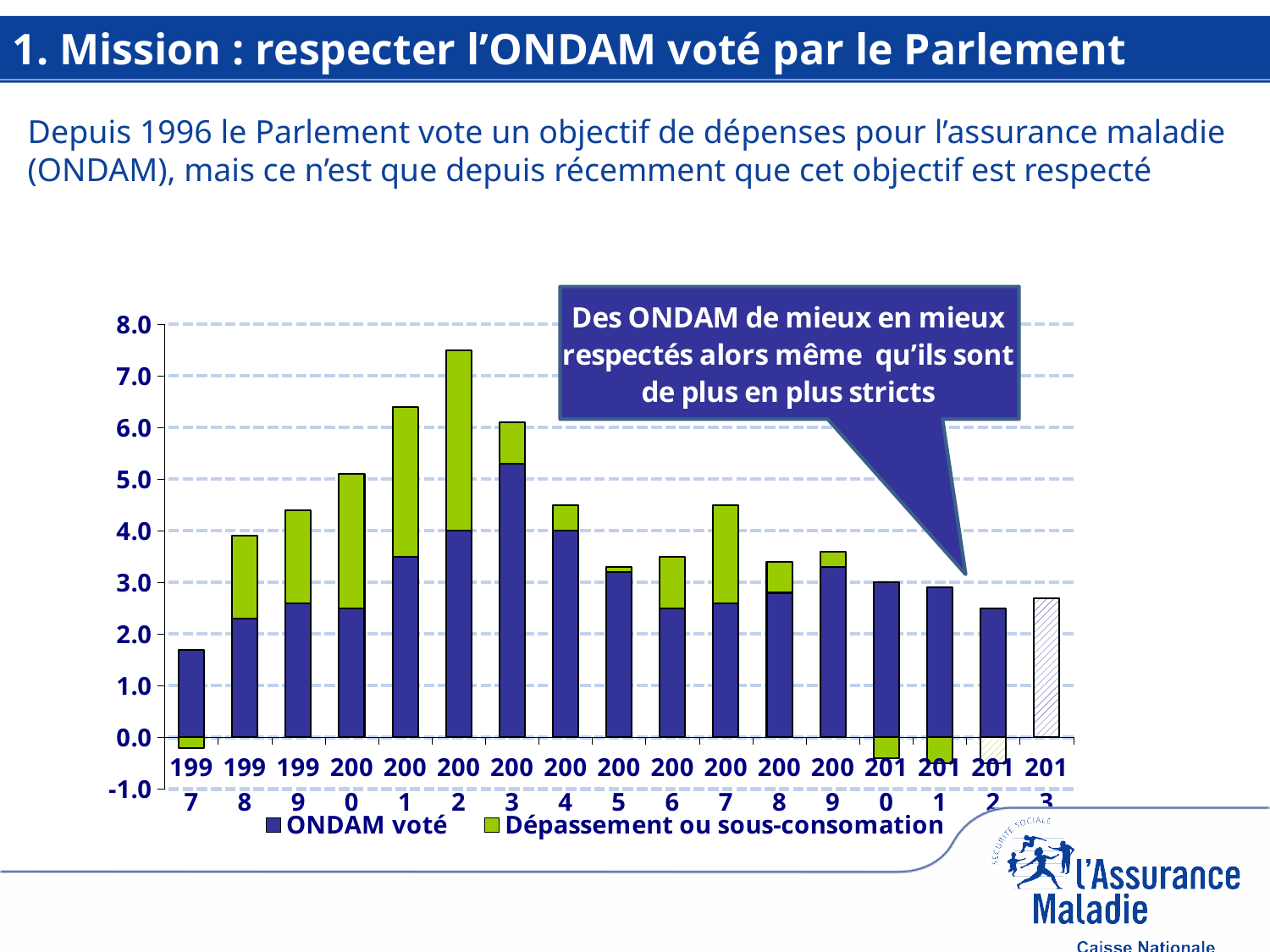
What kind of chart is shown on the slide? Bar chart Is the ONDAM voté value for 1997 greater or less than 2.0? less What colour represents the ONDAM voté series in the chart? Blue How many years are shown on the x axis of the chart? 17 Is the ONDAM voté value for 2003 greater or less than 5.0? greater Does the ONDAM voté value rise or fall from 2009 to 2012? Fall In which year is the ONDAM voté value the lowest? 1997 Is the total height of the stacked bar for 2002 greater or less than 7.0? greater Which year has the larger ONDAM voté value, 2001 or 2003? 2003 Which year has the tallest stacked bar overall? 2002 In which year is the ONDAM voté value the highest? 2003 How many series does the legend list? 2